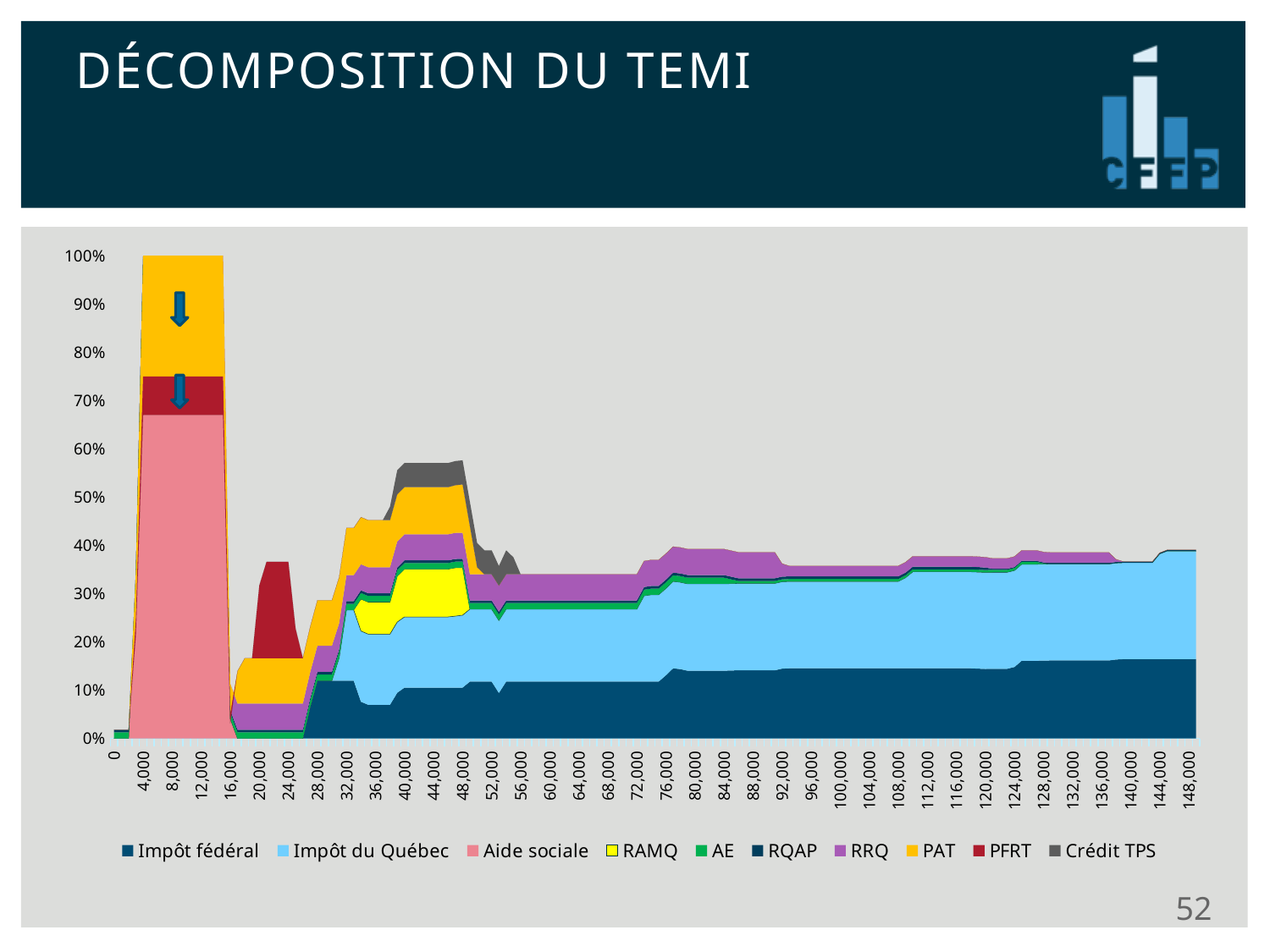
How many series does the legend list? 10 Does the total stacked value rise or fall between 12,000 and 16,000 on the x axis? fall Is the total stacked value at 60,000 greater or less than 40%? less Is the total stacked value at 8,000 greater or less than 90%? greater What kind of chart is shown on the slide? stacked area chart Is the total stacked value at 8,000 larger or smaller than the total at 100,000? larger Is the total stacked value at 40,000 greater or less than 50%? greater What is the highest value shown on the y axis? 100% Which series is listed first in the legend? Impôt fédéral Which series accounts for the largest share of the stack at 8,000? Aide sociale What is the title of the slide containing the chart? DÉCOMPOSITION DU TEMI